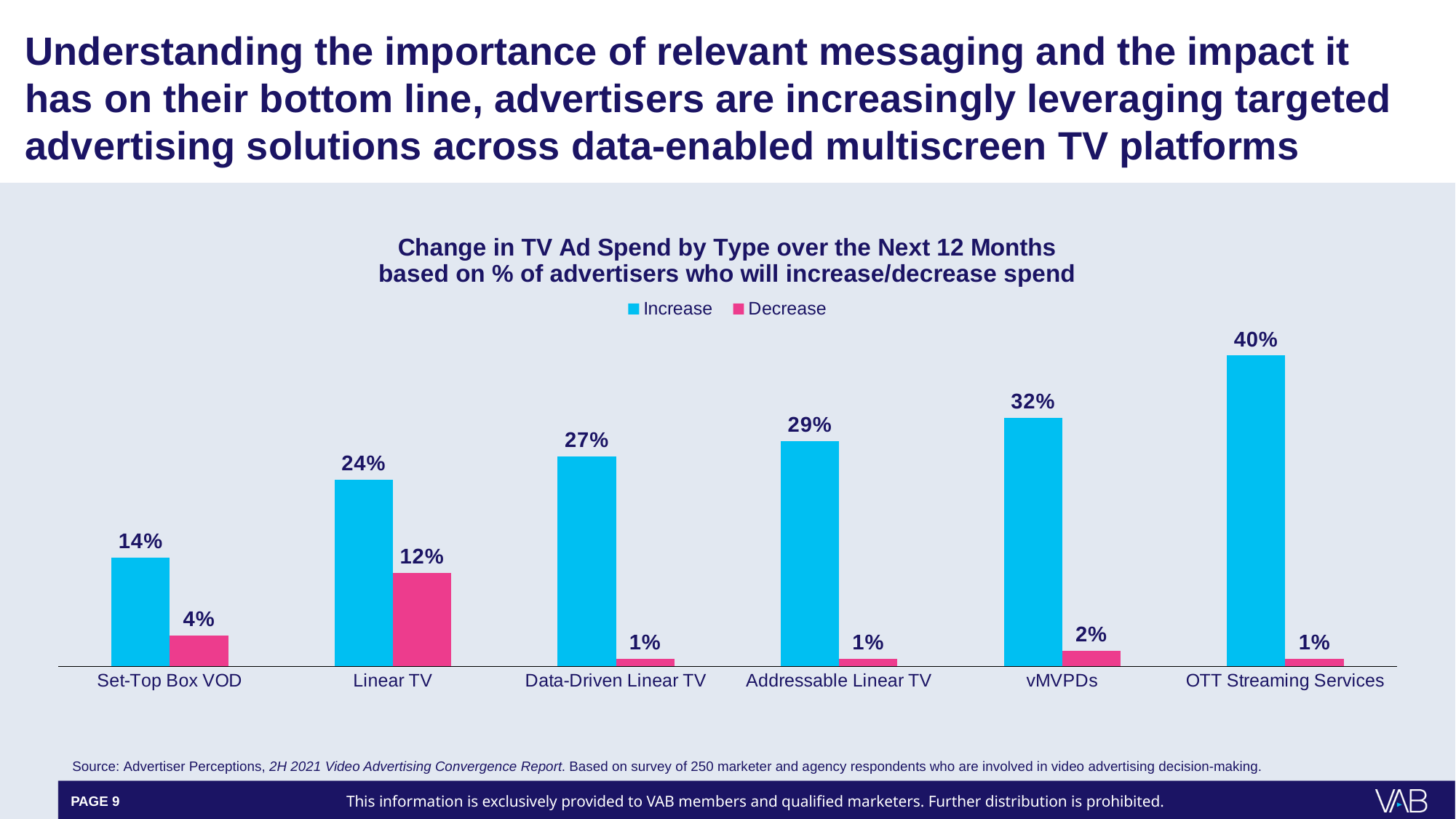
What is the difference between the Increase values for vMVPDs and Set-Top Box VOD? 18% Which is larger, the Increase value for Data-Driven Linear TV or for Linear TV? Data-Driven Linear TV What kind of chart is shown on the slide? Bar chart How many categories are shown on the x axis? 6 How many series does the legend list? 2 What is the Increase value for Addressable Linear TV? 29% Which category has the lowest Increase value? Set-Top Box VOD Which category has the highest Decrease value? Linear TV What is the Decrease value for Linear TV? 12% What percentage of advertisers will increase spend on OTT Streaming Services? 40% Which category has the highest Increase value? OTT Streaming Services Which series is shown in pink? Decrease